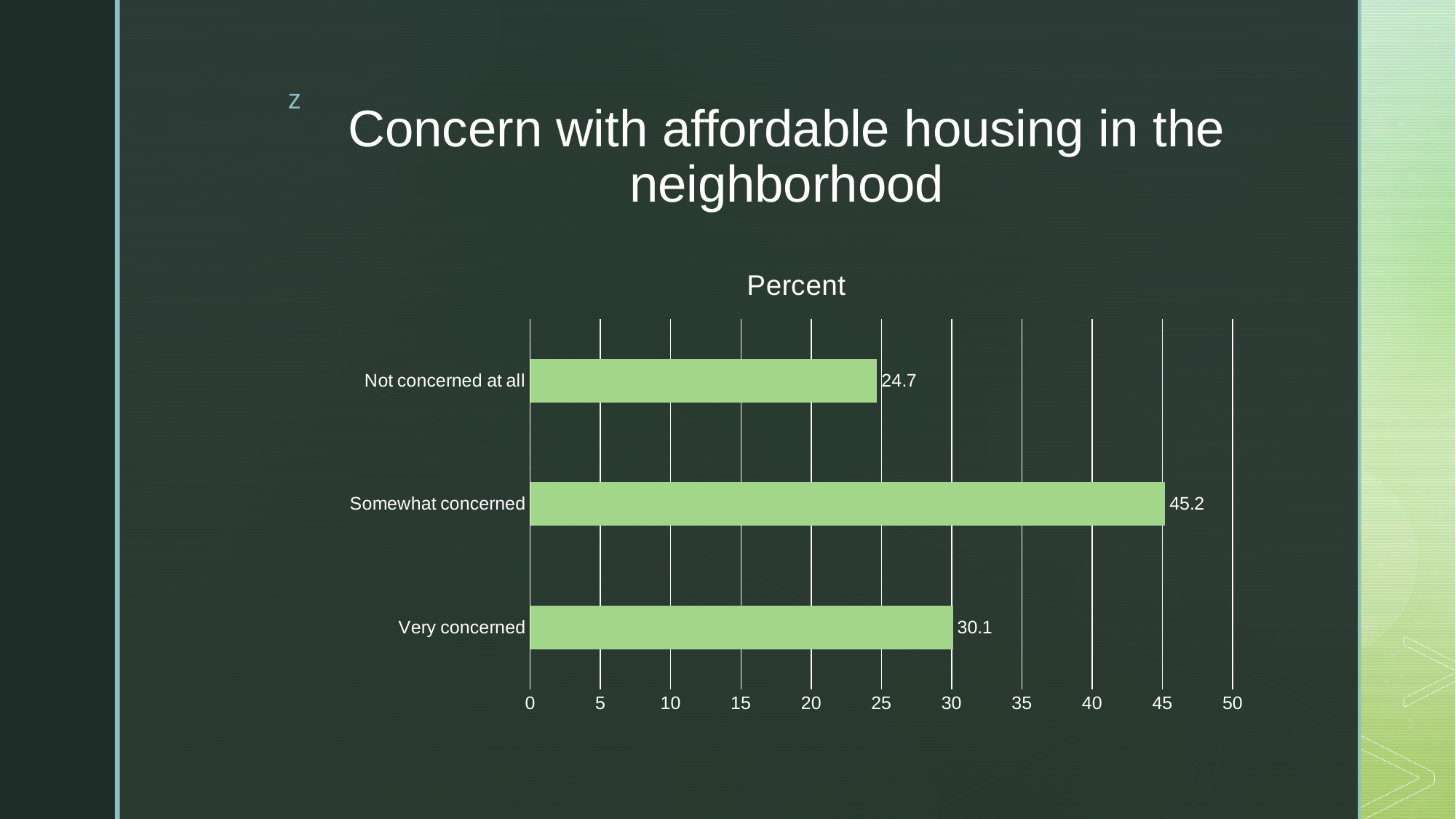
What is the difference between the values for Somewhat concerned and Very concerned? 15.1 Which category has the lowest value? Not concerned at all How many categories are shown in the chart? 3 Which is larger, the value for Very concerned or the value for Not concerned at all? Very concerned Which category has the highest value? Somewhat concerned What is the title of the chart? Percent What is the value for Somewhat concerned? 45.2 What is the difference between the values for Very concerned and Not concerned at all? 5.4 What is the value for Not concerned at all? 24.7 What is the value for Very concerned? 30.1 Is the value for Somewhat concerned greater or less than 40? greater What kind of chart is shown on the slide? bar chart